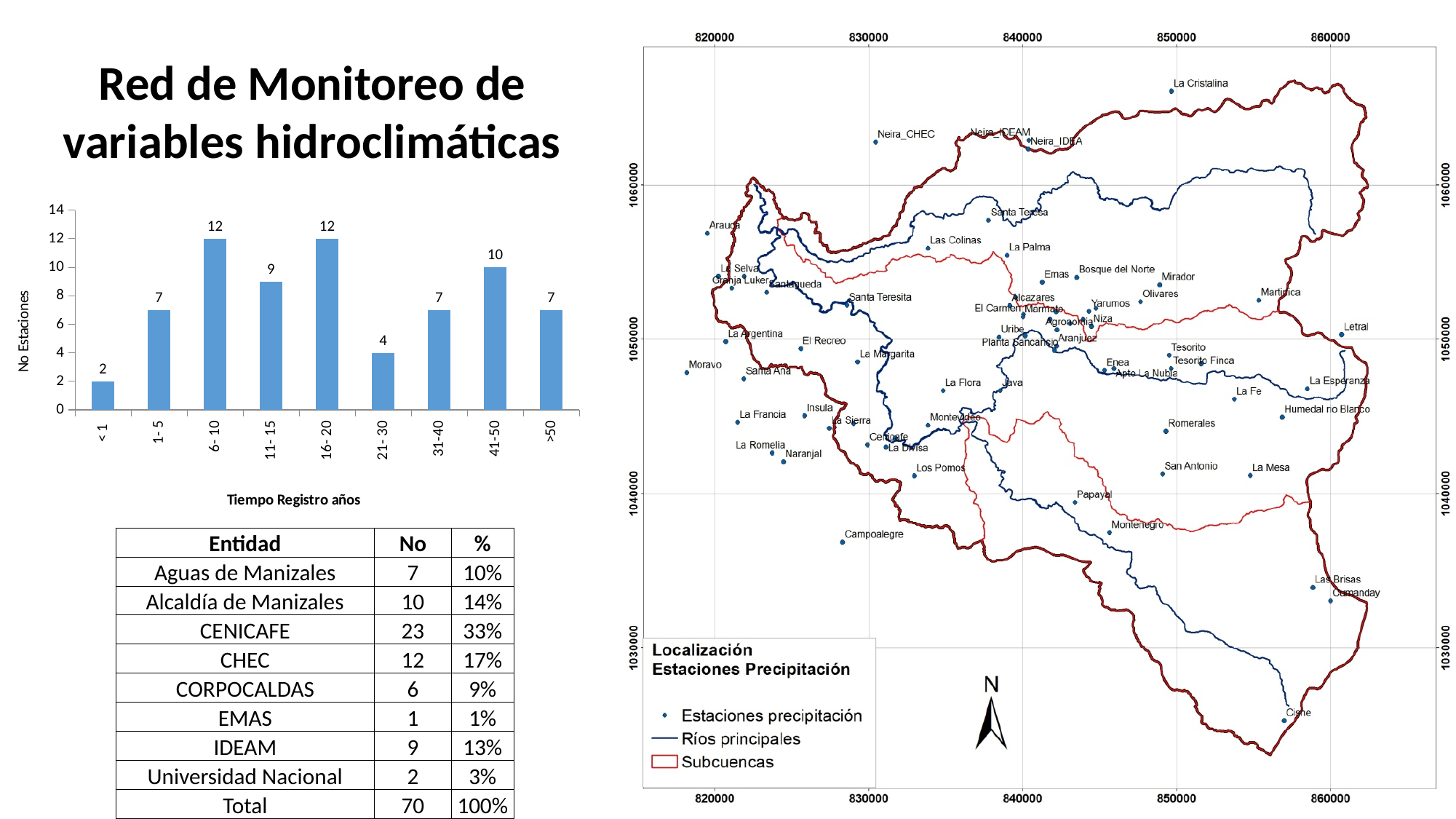
In the bar chart, how many stations have a record time of 41-50 years? 10 In the bar chart, which is larger: the value for '11- 15' or the value for '31-40'? 11- 15 In the bar chart, what is the number of stations for the '21- 30' category? 4 What kind of chart is used to show the number of stations by record time? Bar chart In the bar chart, what is the value for the '< 1' category? 2 In the bar chart, which category has the lowest number of stations? < 1 What is the label of the x axis of the bar chart? Tiempo Registro años In the bar chart, what is the value for the '11- 15' category? 9 In the bar chart, what is the difference between the values for '6- 10' and '1- 5'? 5 In the bar chart, what is the difference between the values for '41-50' and '21- 30'? 6 How many categories are shown on the x axis of the bar chart? 9 In the bar chart, which two categories share the highest value of 12? 6- 10 and 16- 20